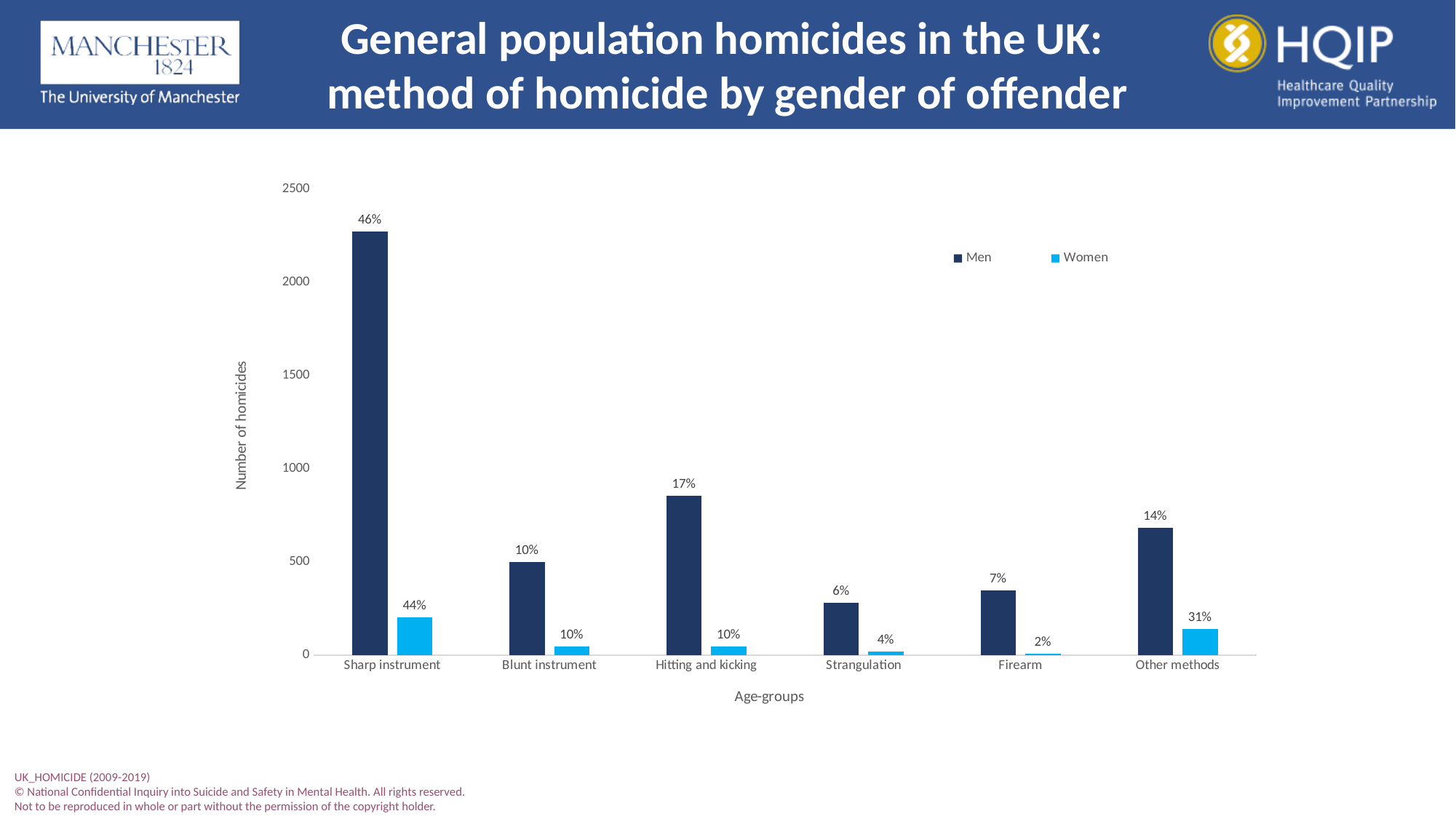
Is the number of homicides for Men by Other methods greater or less than 500? greater What percentage label is shown on the Women bar for Other methods? 31% What percentage label is shown on the Women bar for Strangulation? 4% Is the number of homicides for Men by Hitting and kicking greater or less than 1000? less Which method has the lowest Women bar? Firearm Is the number of homicides for Men by Sharp instrument greater or less than 2000? greater What kind of chart is shown on the slide? bar chart Which method has the tallest Men bar? Sharp instrument What percentage label is shown on the Men bar for Sharp instrument? 46% Which is larger for Men: the bar for Blunt instrument or the bar for Strangulation? Blunt instrument How many series does the legend list? 2 How many method categories are shown on the x axis? 6